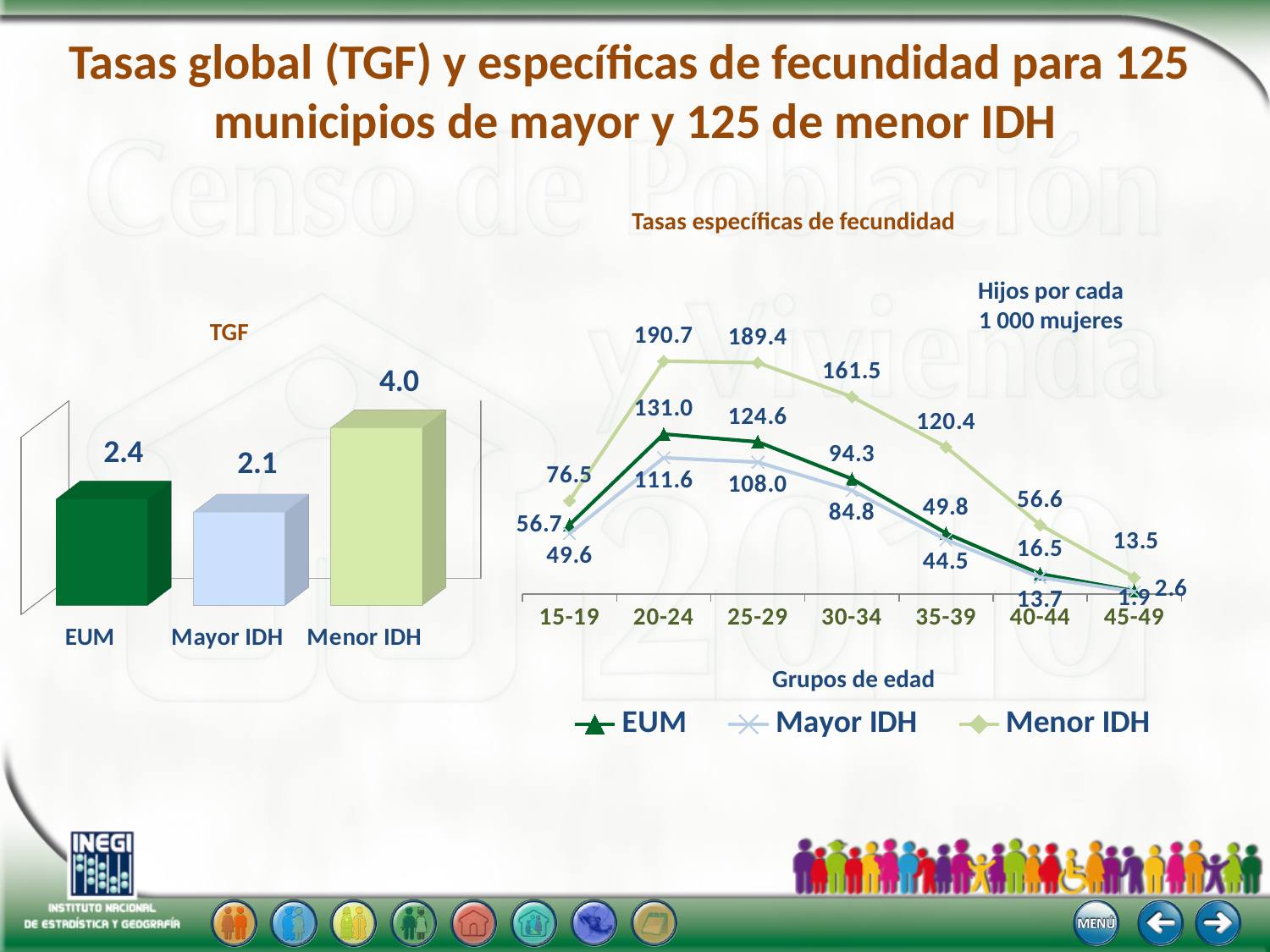
In the TGF chart, which category has the lowest value? Mayor IDH In the TGF chart, what is the value for Menor IDH? 4.0 In the Tasas específicas de fecundidad chart, which age group has the highest value for EUM? 20-24 In the Tasas específicas de fecundidad chart, what is the value for Mayor IDH in the 30-34 age group? 84.8 In the Tasas específicas de fecundidad chart, what is the difference between Menor IDH and EUM in the 25-29 age group? 64.8 How many categories does the TGF chart show? 3 What kind of chart is the TGF chart? Bar chart In the Tasas específicas de fecundidad chart, which is larger in the 35-39 age group: EUM or Mayor IDH? EUM In the TGF chart, what is the difference between Menor IDH and EUM? 1.6 In the Tasas específicas de fecundidad chart, do the values for Menor IDH rise or fall from the 25-29 age group to the 45-49 age group? Fall In the Tasas específicas de fecundidad chart, what is the value for Menor IDH in the 20-24 age group? 190.7 How many series does the legend of the Tasas específicas de fecundidad chart list? 3